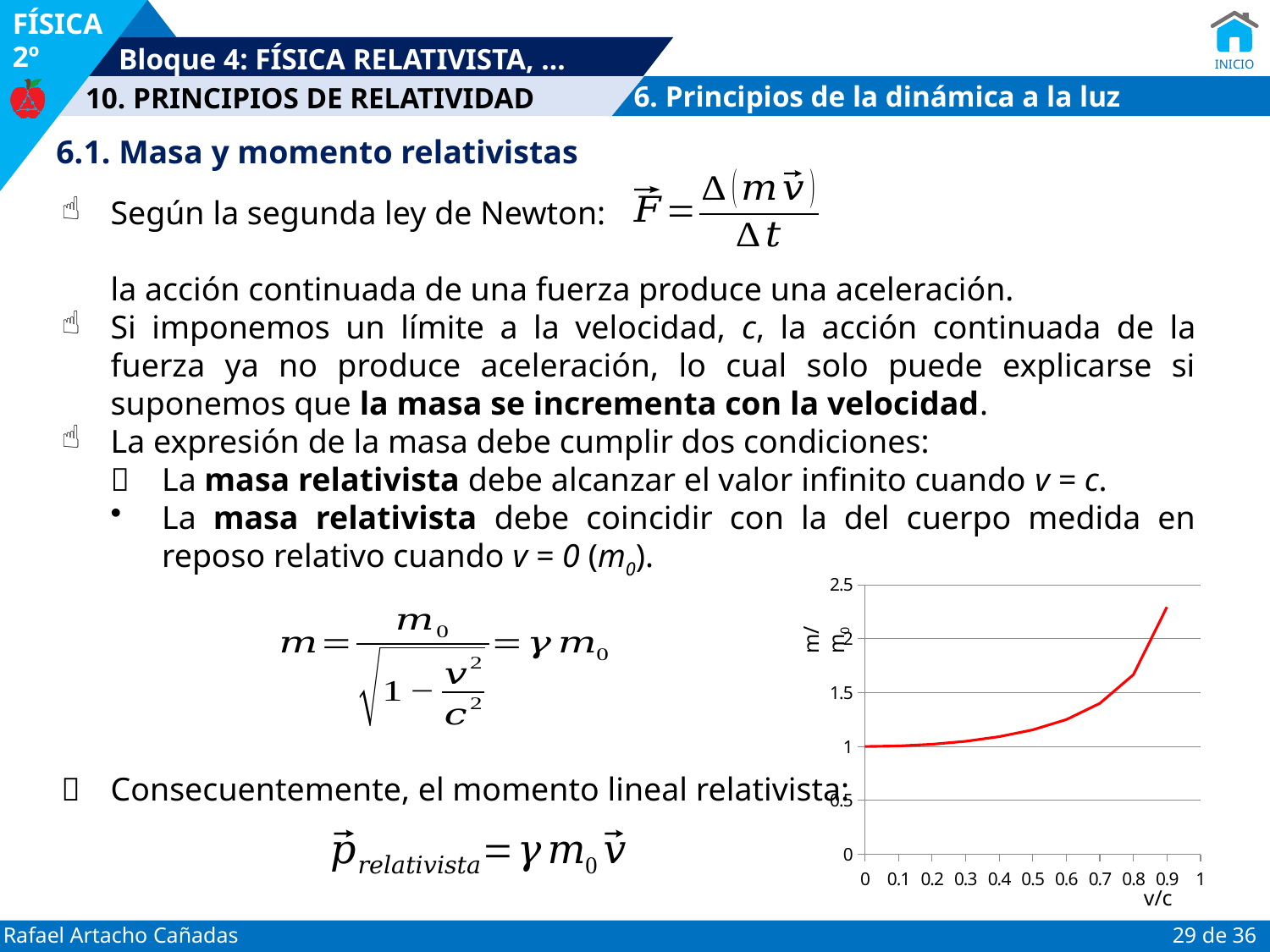
Is the value of m/m0 at v/c = 0.9 greater or less than 2? greater Which has the larger m/m0 value, v/c = 0.9 or v/c = 0.5? v/c = 0.9 What is the value of m/m0 at v/c = 0? 1 Does the plotted value rise or fall as v/c increases from 0 to 0.9? rise At which v/c value is m/m0 lowest on the chart? 0 Is the value of m/m0 at v/c = 0.5 greater or less than 1.5? less What kind of chart is shown on the slide? line chart What is the label of the y axis of the chart? m/m0 Is the value of m/m0 at v/c = 0.7 greater or less than 2? less At which v/c value is m/m0 highest on the chart? 0.9 What is the label of the x axis of the chart? v/c